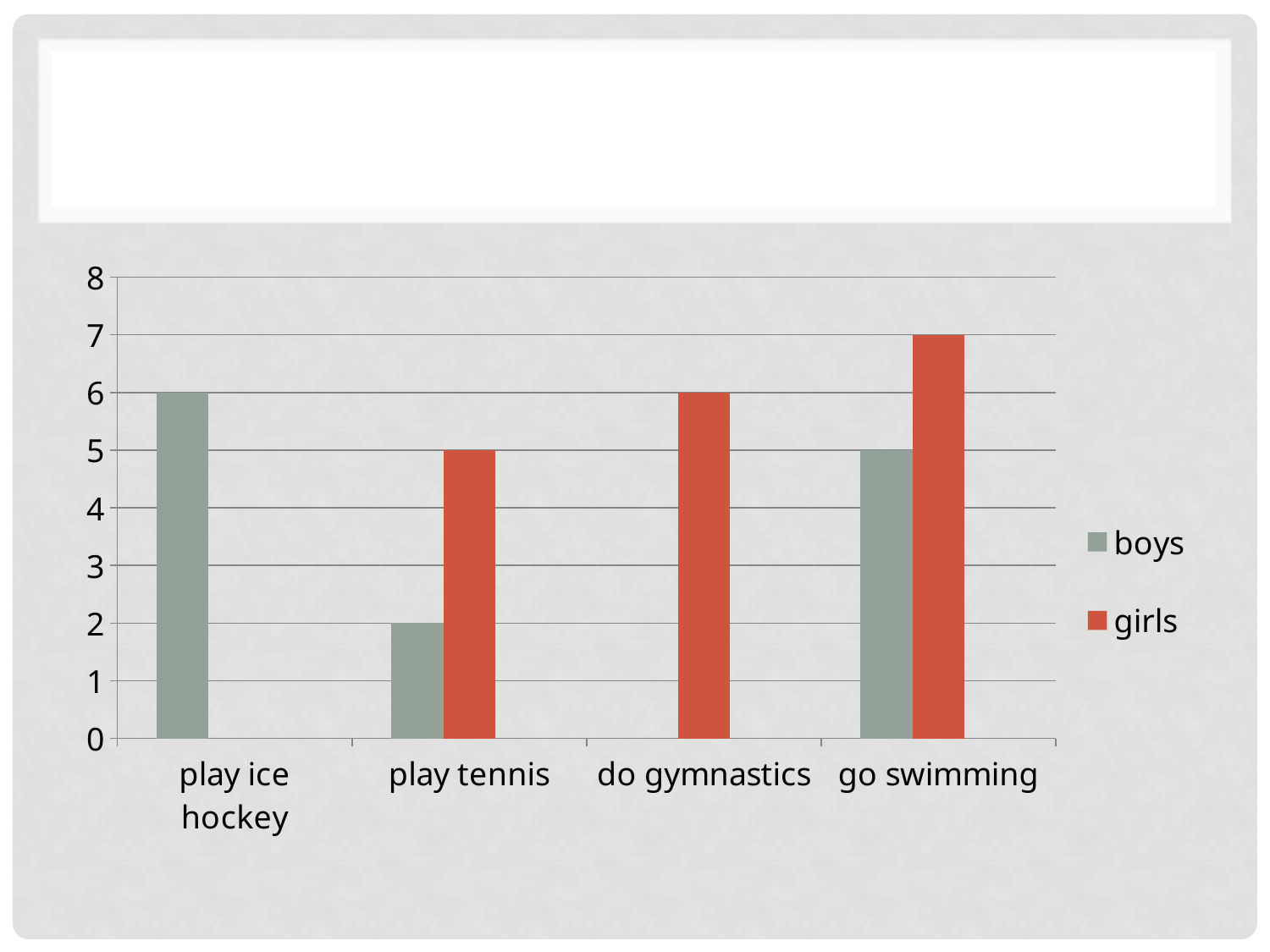
Which series is shown in red in the legend? girls What is the value for boys for play tennis? 2 What is the value for boys for play ice hockey? 6 What is the value for girls for go swimming? 7 Which activity has the highest value for boys? play ice hockey What kind of chart is shown on the slide? bar chart Which activity has the highest value for girls? go swimming What is the difference between the girls and boys values for play tennis? 3 How many activity categories are shown on the x axis? 4 What is the value for girls for do gymnastics? 6 How many series does the legend list? 2 For go swimming, which is larger: the value for boys or the value for girls? girls